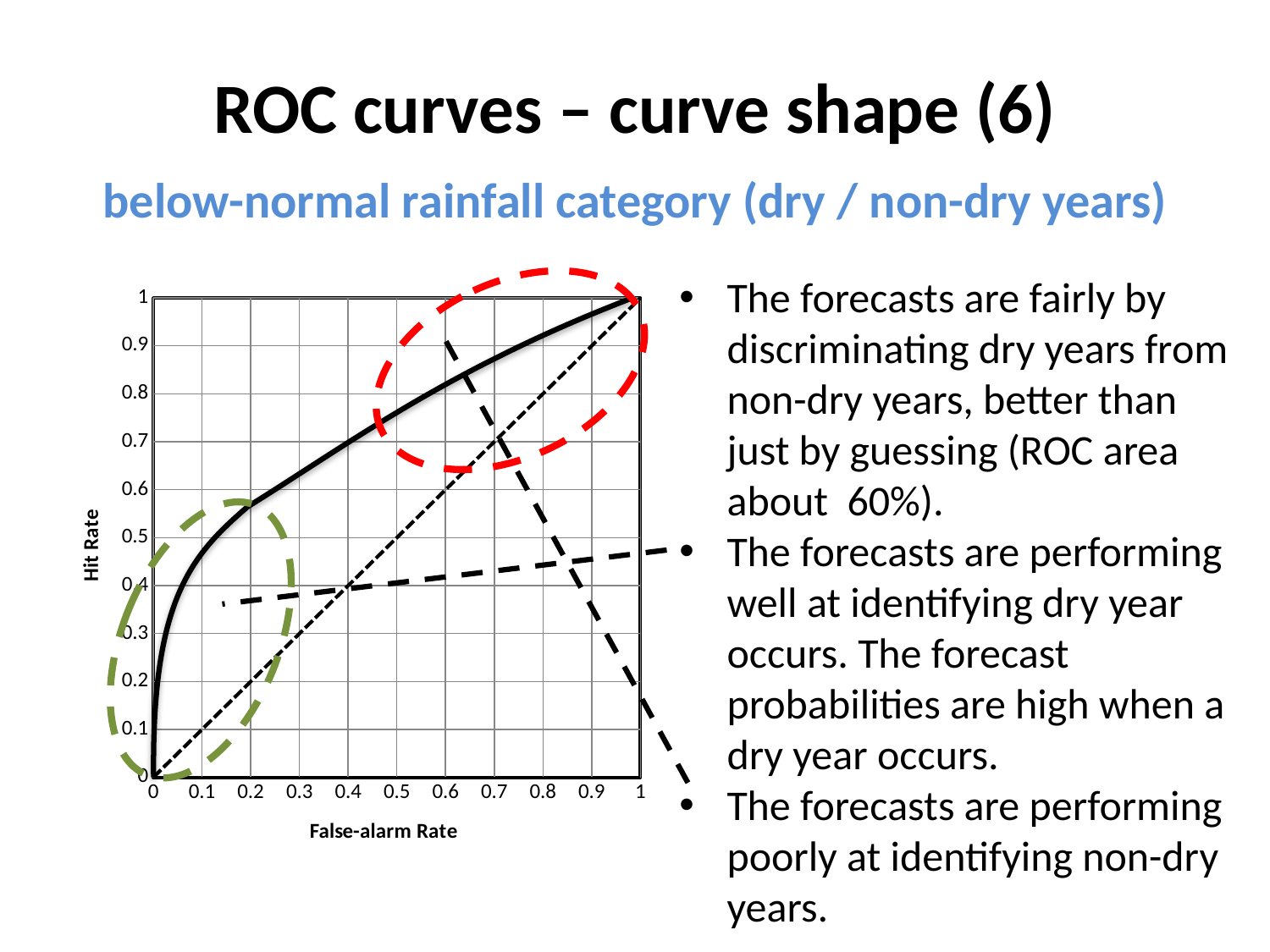
What is the label of the x axis of the chart? False-alarm Rate Does the solid ROC curve rise or fall as the false-alarm rate increases from 0 to 1? rise At a false-alarm rate of 0.4, which is higher: the solid ROC curve or the dashed diagonal line? the solid ROC curve What is the label of the y axis of the chart? Hit Rate Is the hit rate of the solid curve at a false-alarm rate of 0.2 greater or less than 0.5? greater What is the highest value shown on the y axis of the chart? 1 What kind of chart is shown on the slide? line chart What is the hit rate of the solid curve at a false-alarm rate of 0? 0 Is the hit rate of the solid curve at a false-alarm rate of 0.1 greater or less than 0.4? greater What is the hit rate of the solid curve at a false-alarm rate of 1? 1 Is the hit rate of the solid curve at a false-alarm rate of 0.5 greater or less than 0.7? greater